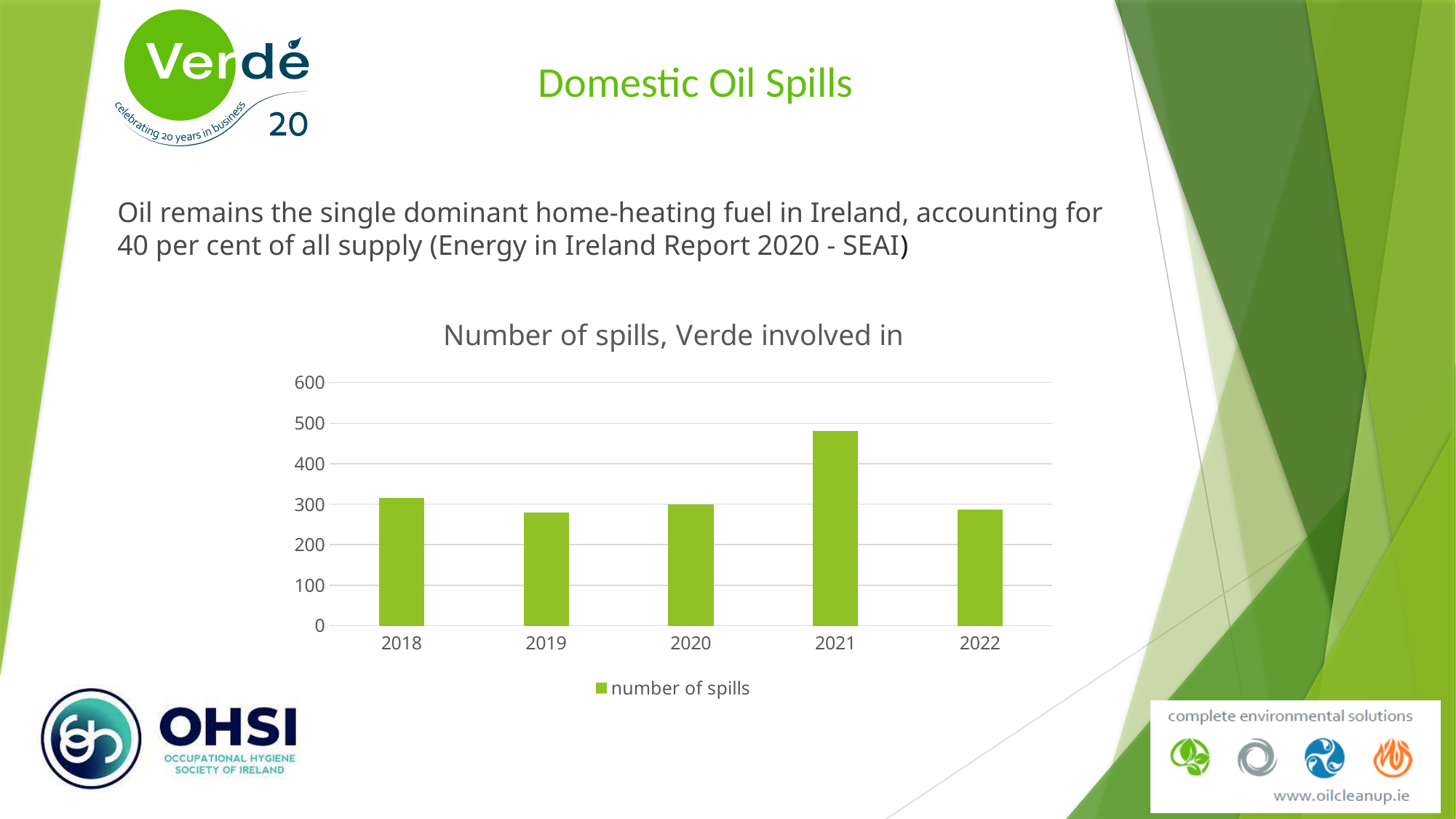
What is the title of the chart? Number of spills, Verde involved in Is the value for 2018 greater or less than 300? greater Which year has the larger number of spills, 2020 or 2021? 2021 Which year has the highest number of spills? 2021 What kind of chart is shown on the slide? bar chart Does the number of spills rise or fall from 2021 to 2022? fall How many years are shown on the x axis of the chart? 5 Is the value for 2021 greater or less than 400? greater How many series does the chart legend list? 1 Is the value for 2021 greater or less than 500? less What is the name of the series shown in the legend? number of spills